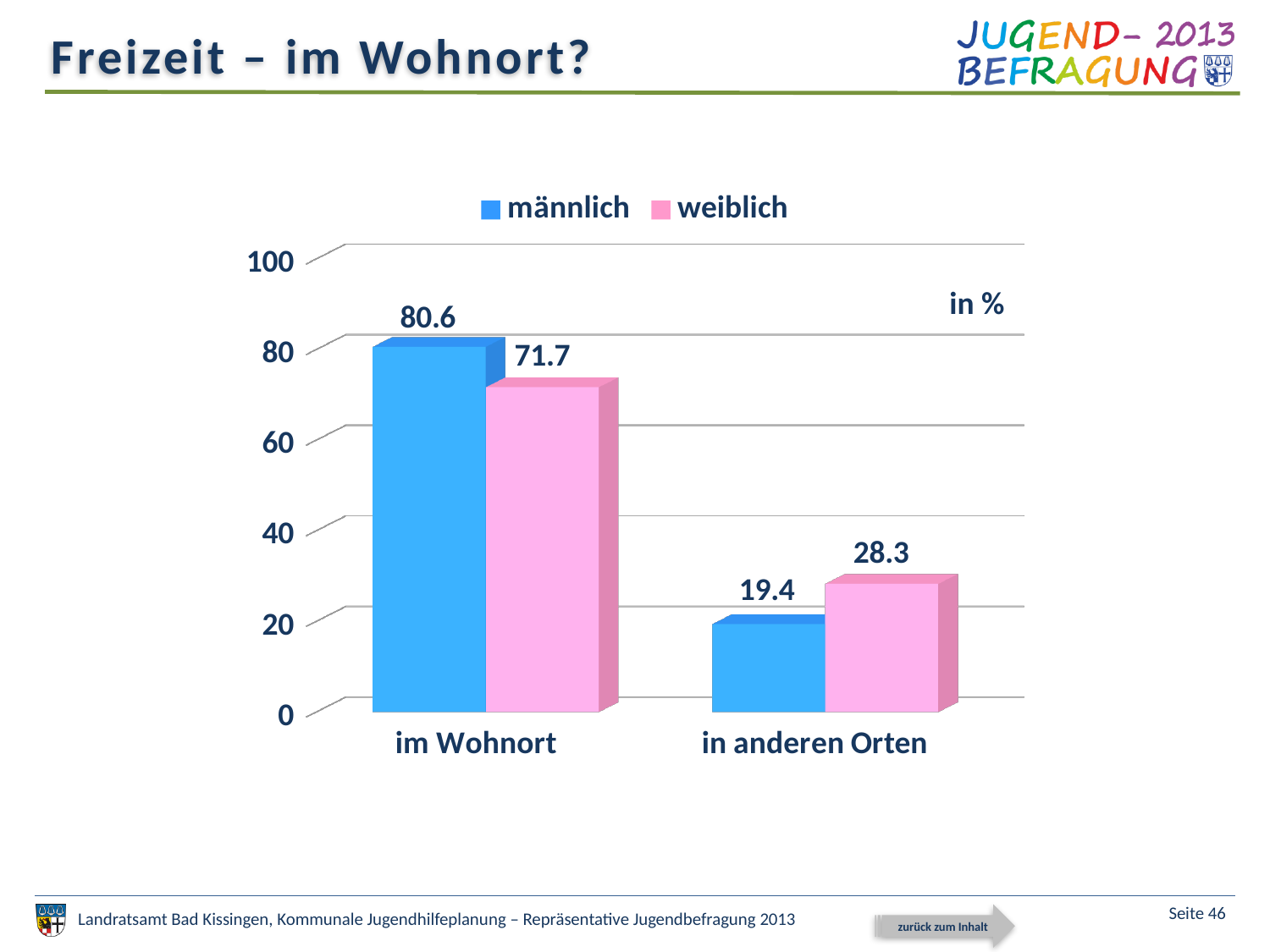
What is the difference between the männlich and weiblich values for im Wohnort? 8.9 Which is larger for in anderen Orten: männlich or weiblich? weiblich Which category has the highest value for männlich? im Wohnort Which category has the lowest value for weiblich? in anderen Orten What is the value for männlich in the category in anderen Orten? 19.4 What is the value for weiblich in the category im Wohnort? 71.7 What is the value for weiblich in the category in anderen Orten? 28.3 Is the value for weiblich in im Wohnort greater or less than 60? greater What kind of chart is shown on the slide? bar chart How many categories are shown on the x axis? 2 How many series does the legend list? 2 What is the value for männlich in the category im Wohnort? 80.6